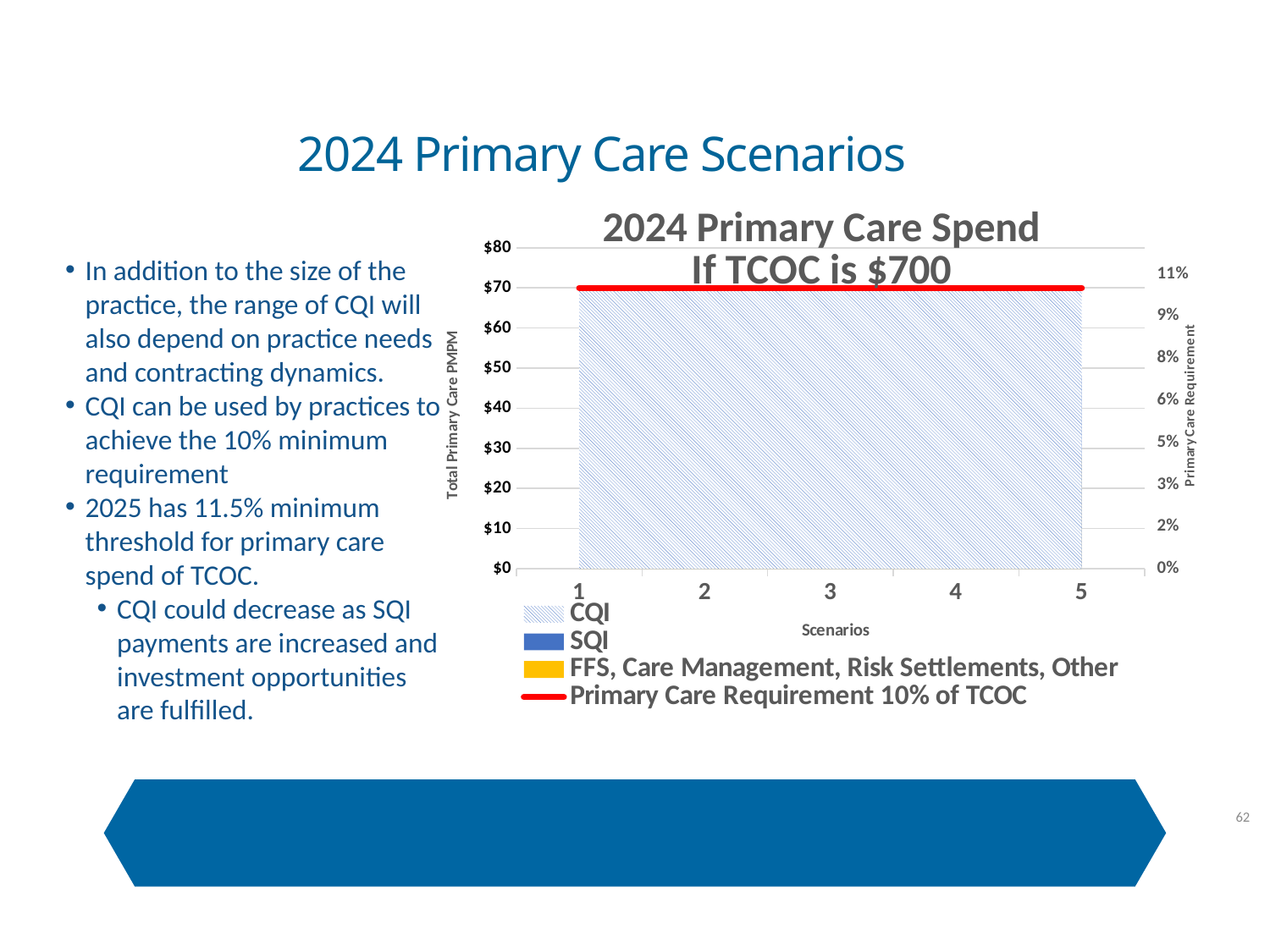
Does the CQI area rise, fall, or stay flat from scenario 1 to scenario 5? stays flat Which legend entry is drawn as a red line? Primary Care Requirement 10% of TCOC At what value on the left axis does the Primary Care Requirement 10% of TCOC line sit? $70 What is the highest tick shown on the right y axis? 11% Is the CQI value at scenario 1 greater or less than $80? less What is the highest tick shown on the left y axis? $80 How many scenarios are shown along the x axis of the chart? 5 Is the CQI value at scenario 3 greater or less than $60? greater What is the title of the chart? 2024 Primary Care Spend If TCOC is $700 How many entries does the chart's legend list? 4